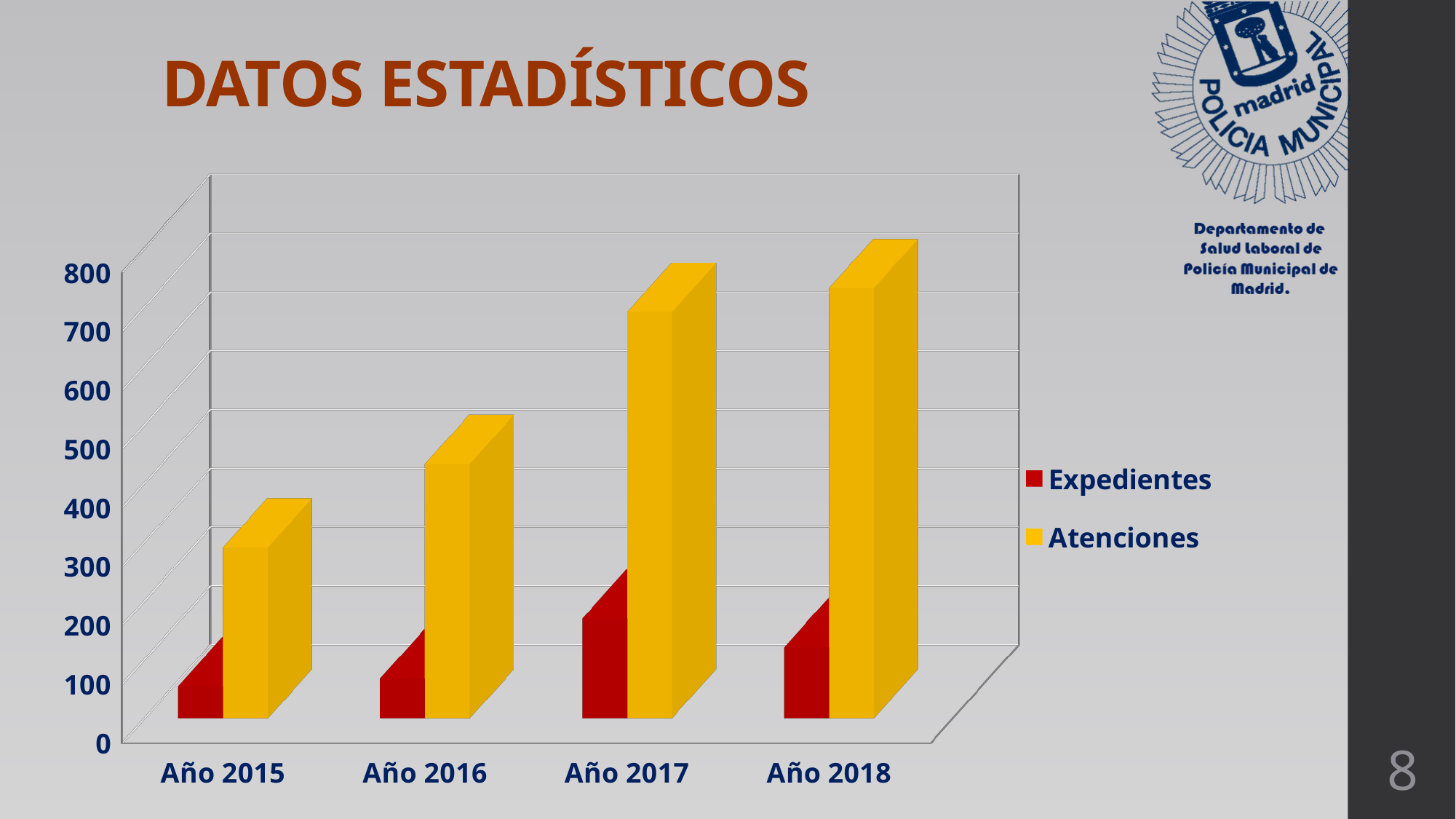
Do the Atenciones values rise or fall from Año 2015 to Año 2018? rise Is the value for Expedientes in Año 2015 greater or less than 300? less Which year has the highest value for Expedientes? Año 2017 In Año 2017, which is larger: Expedientes or Atenciones? Atenciones Is the value for Atenciones in Año 2018 greater or less than 600? greater How many years (categories) are shown on the x axis of the chart? 4 How many series does the chart's legend list? 2 What is the title of the slide containing the chart? DATOS ESTADÍSTICOS What kind of chart is shown on the slide? bar chart Which year has the lowest value for Atenciones? Año 2015 Is the value for Atenciones in Año 2015 greater or less than 400? less Which year has the highest value for Atenciones? Año 2018